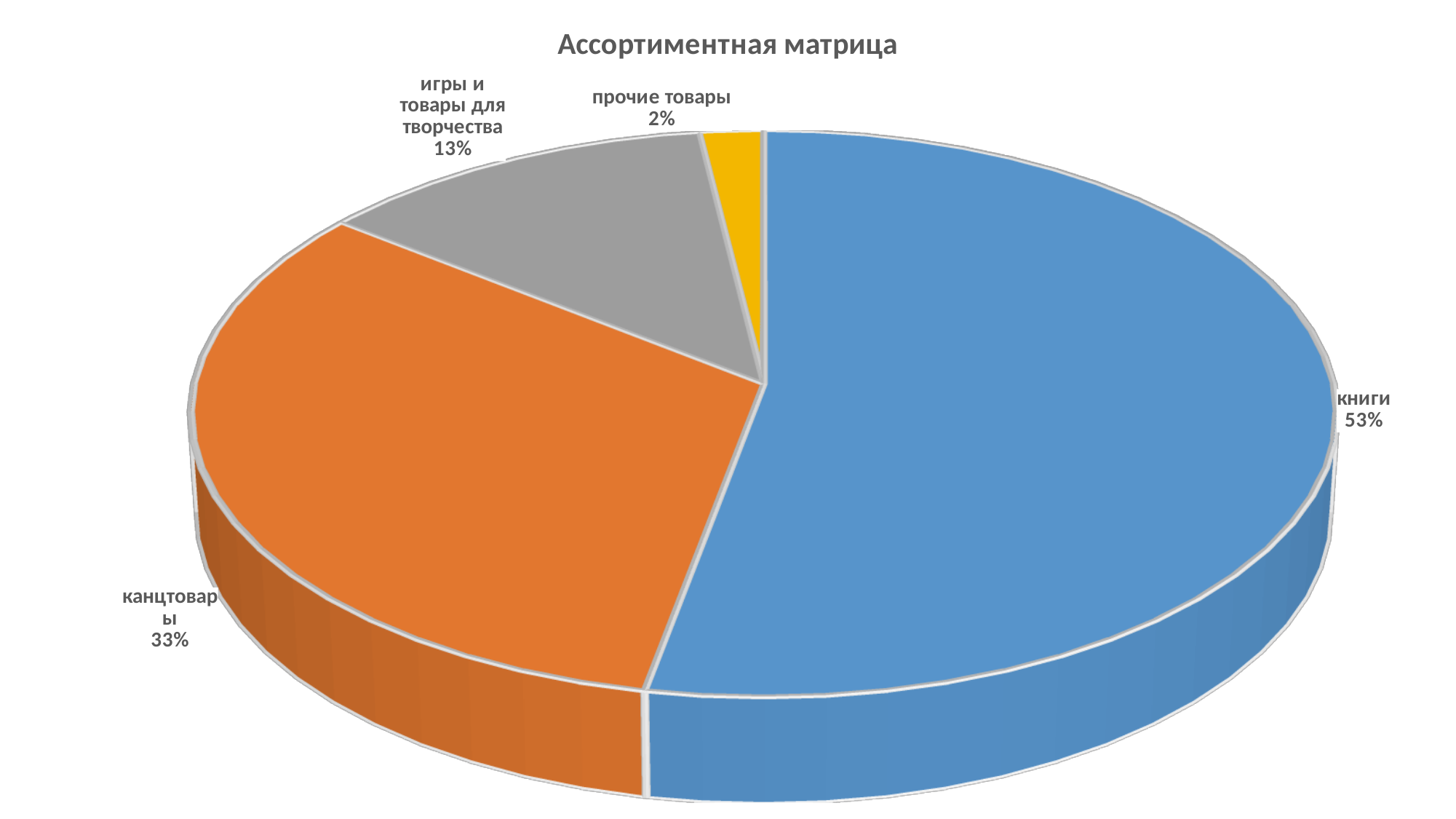
What share of the pie does игры и товары для творчества have? 13% How many categories are shown in the pie chart? 4 Which is larger, the share for канцтовары or the share for игры и товары для творчества? канцтовары What share of the pie does прочие товары have? 2% What is the difference in percentage points between книги and канцтовары? 20 What share of the pie does книги have? 53% What is the title of the chart? Ассортиментная матрица What colour is the slice for книги? blue What kind of chart is shown on the slide? pie chart Which category has the smallest slice of the pie? прочие товары Which category has the largest slice of the pie? книги